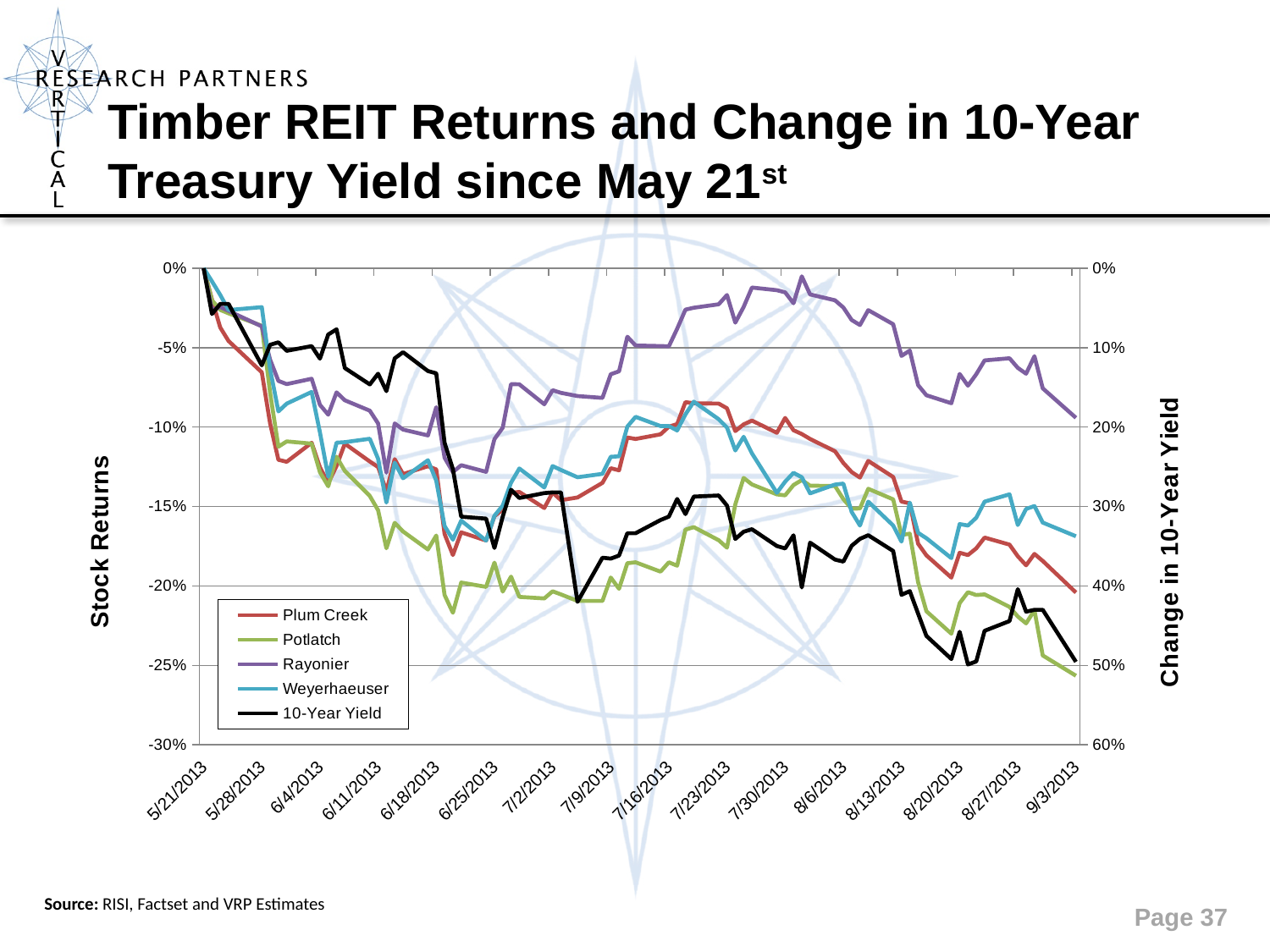
Which series are listed in the legend? Plum Creek, Potlatch, Rayonier, Weyerhaeuser, 10-Year Yield Is the Rayonier return around 7/30/2013 greater or less than -5%? greater What is the title of the right-hand vertical axis? Change in 10-Year Yield How many date labels are shown on the x axis? 16 Which stock series has the highest (least negative) return at 9/3/2013? Rayonier Which stock series has the lowest return at 9/3/2013? Potlatch At 9/3/2013, which is higher, the Plum Creek return or the Weyerhaeuser return? Weyerhaeuser Does the Potlatch line generally rise or fall from 5/21/2013 to 9/3/2013? Fall Is the Plum Creek return at 9/3/2013 greater or less than -15%? less What kind of chart is shown on the slide? Line chart How many series does the legend list? 5 Is the Potlatch return at 9/3/2013 greater or less than -20%? less